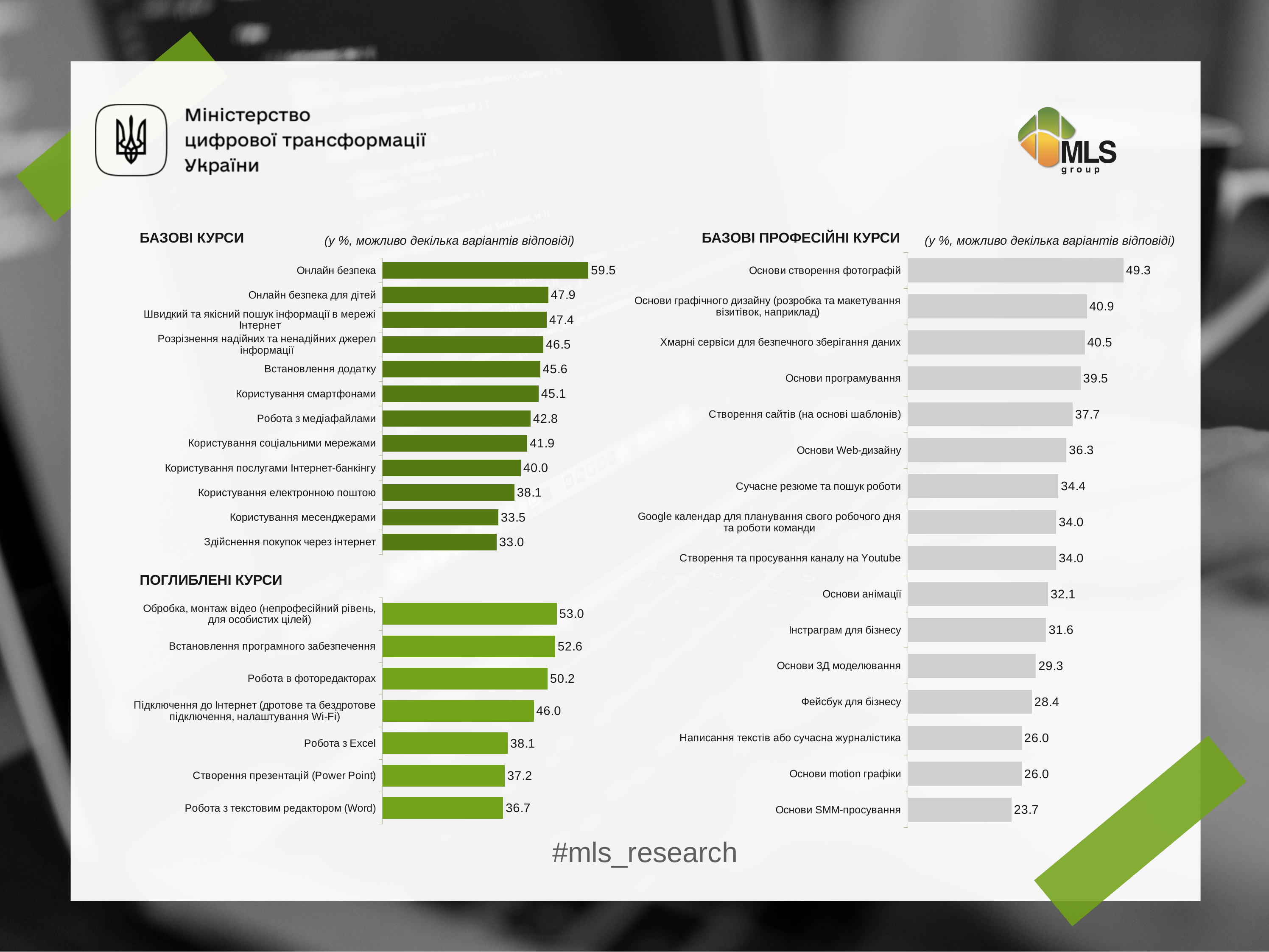
In the 'ПОГЛИБЛЕНІ КУРСИ' chart, which category has the highest value? Обробка, монтаж відео (непрофесійний рівень, для особистих цілей) In the 'БАЗОВІ КУРСИ' chart, what is the value for 'Онлайн безпека'? 59.5 What type of chart is used for 'БАЗОВІ ПРОФЕСІЙНІ КУРСИ'? Bar chart In the 'БАЗОВІ КУРСИ' chart, what is the difference between 'Онлайн безпека' and 'Онлайн безпека для дітей'? 11.6 How many categories are shown in the 'БАЗОВІ ПРОФЕСІЙНІ КУРСИ' chart? 16 In the 'БАЗОВІ КУРСИ' chart, which category has the lowest value? Здійснення покупок через інтернет How many categories are shown in the 'ПОГЛИБЛЕНІ КУРСИ' chart? 7 In the 'БАЗОВІ ПРОФЕСІЙНІ КУРСИ' chart, which category has the highest value? Основи створення фотографій In the 'БАЗОВІ ПРОФЕСІЙНІ КУРСИ' chart, what is the value for 'Основи програмування'? 39.5 In the 'БАЗОВІ ПРОФЕСІЙНІ КУРСИ' chart, which is larger: 'Основи анімації' or 'Фейсбук для бізнесу'? Основи анімації How many categories are shown in the 'БАЗОВІ КУРСИ' chart? 12 In the 'ПОГЛИБЛЕНІ КУРСИ' chart, what is the value for 'Робота з Excel'? 38.1